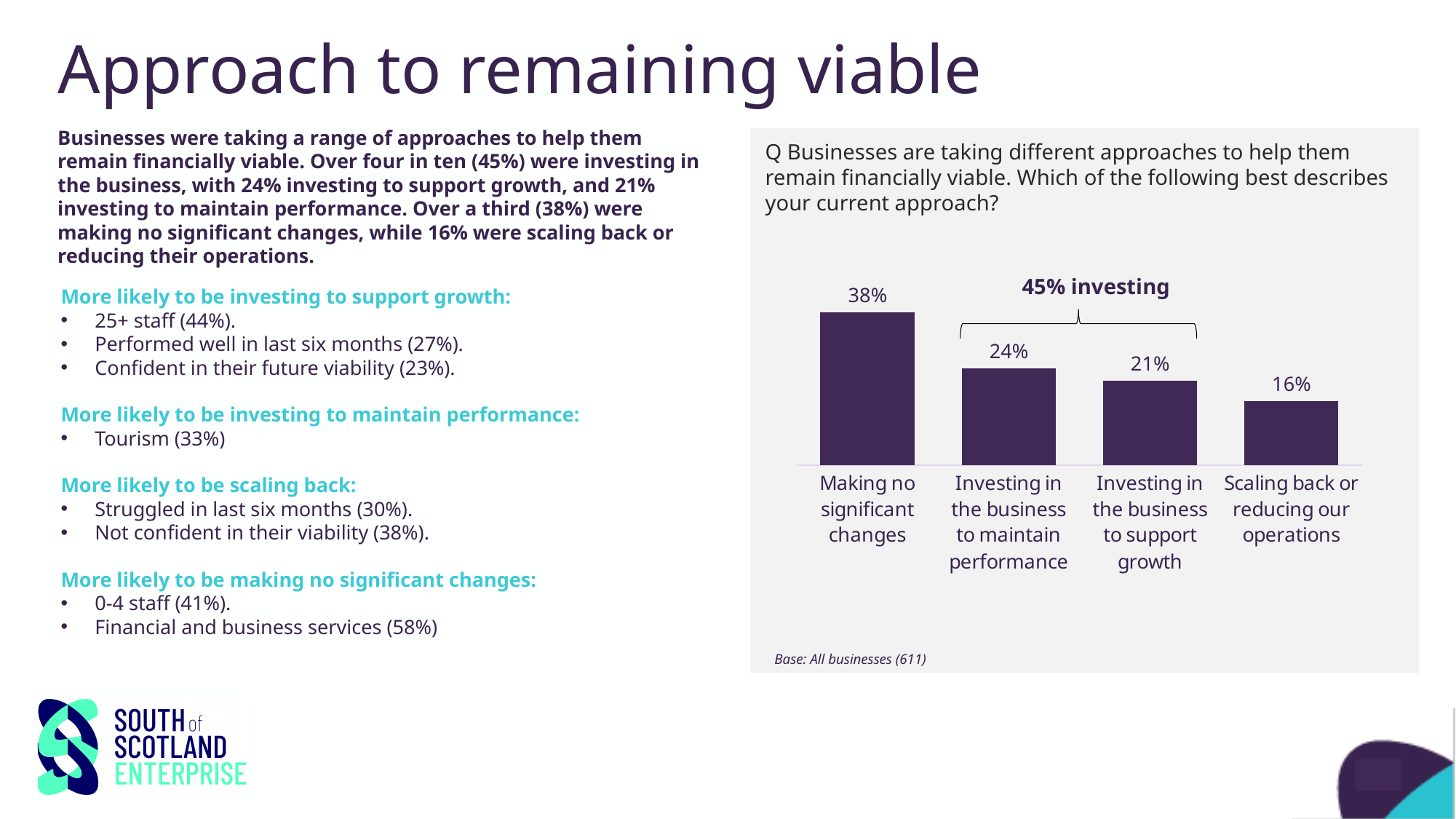
What percentage of businesses are scaling back or reducing their operations? 16% How many approach categories are shown in the chart? 4 What percentage of businesses are making no significant changes? 38% What percentage of businesses are investing in the business to support growth? 21% What type of chart is used to show the approaches to remaining viable? Bar chart Do the bar values rise or fall from left to right across the chart? Fall Which approach has the lowest percentage of businesses? Scaling back or reducing our operations Which approach has the highest percentage of businesses? Making no significant changes What percentage of businesses are investing in the business to maintain performance? 24% What is the difference in percentage points between businesses making no significant changes and those scaling back or reducing operations? 22 What combined percentage is labelled above the bracket spanning the two investing bars? 45% investing Which is larger: the share investing to maintain performance or the share investing to support growth? Investing in the business to maintain performance